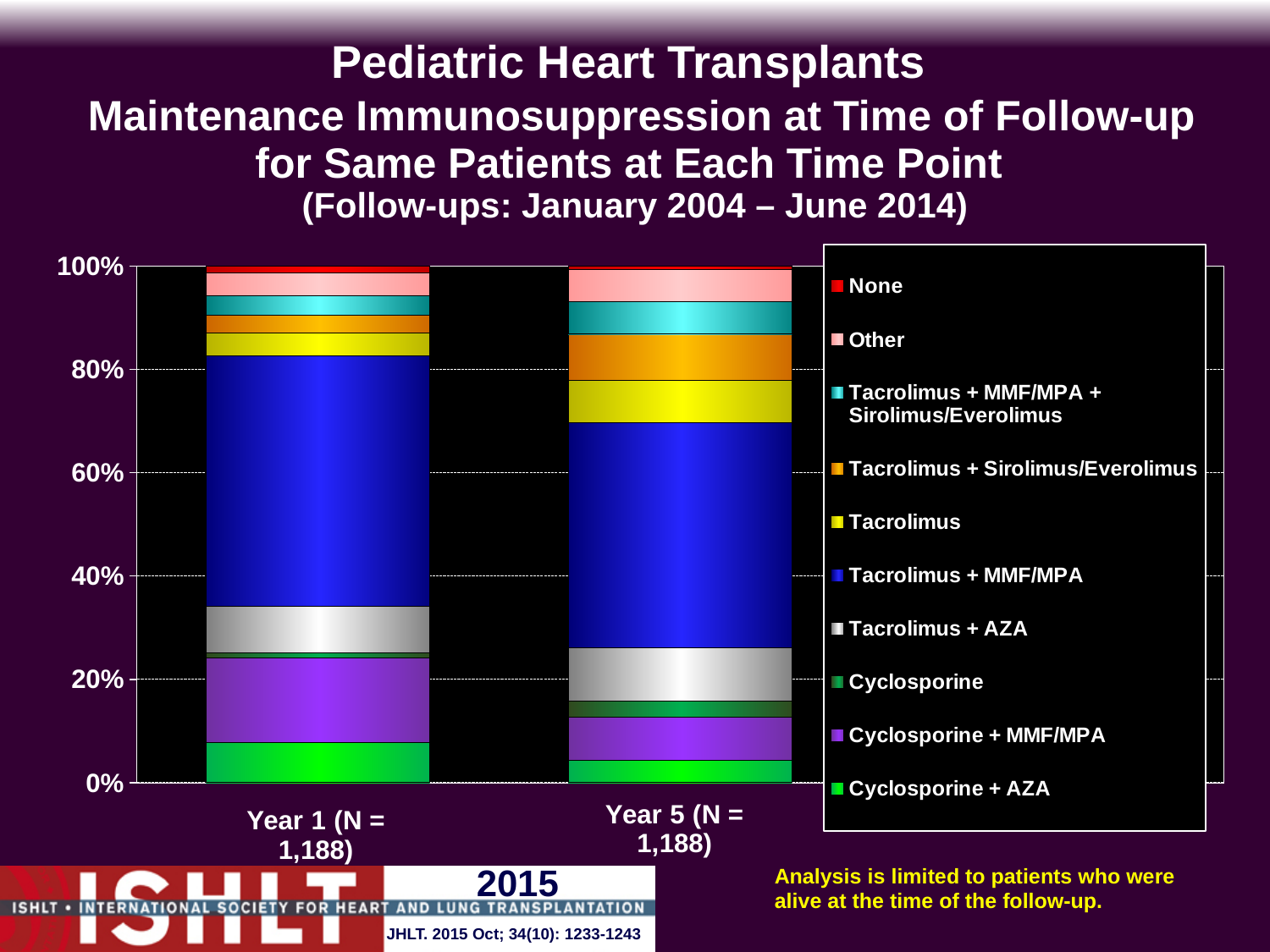
What is the number of patients (N) shown for the Year 1 bar? 1,188 Is the share of Tacrolimus + Sirolimus/Everolimus larger at Year 1 or at Year 5? Year 5 Which immunosuppression regimen makes up the largest segment of the Year 5 bar? Tacrolimus + MMF/MPA How many immunosuppression categories does the legend list? 10 Is the share of Cyclosporine + AZA larger at Year 1 or at Year 5? Year 1 Is the share of Tacrolimus + MMF/MPA in the Year 1 bar greater or less than 40%? greater What is the total of each stacked bar in the chart? 100% Is the share of Cyclosporine + MMF/MPA larger at Year 1 or at Year 5? Year 1 How many bars (time points) are plotted in the chart? 2 Is the share of Cyclosporine + MMF/MPA in the Year 1 bar greater or less than 20%? less Which immunosuppression regimen makes up the largest segment of the Year 1 bar? Tacrolimus + MMF/MPA What kind of chart is shown on the slide? Stacked bar chart